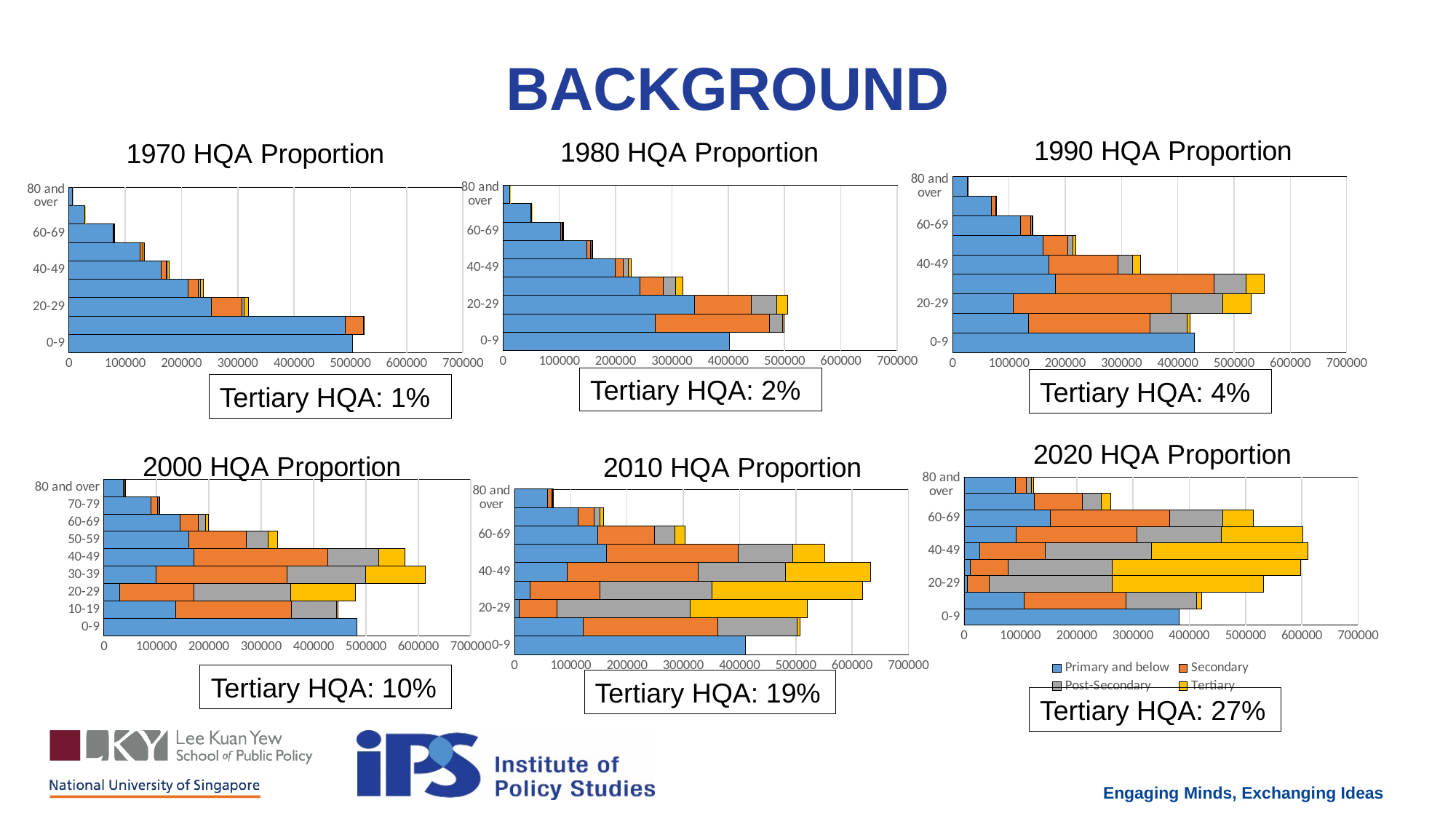
How many age-group categories are plotted in the 2000 HQA Proportion chart? 9 In the 1970 HQA Proportion chart, which age group has the shortest bar? 80 and over In the 2020 HQA Proportion chart, which bar is longer, 0-9 or 30-39? 30-39 How many charts are shown on the slide? 6 What kind of chart is the 1970 HQA Proportion chart? Stacked horizontal bar chart In the 1970 HQA Proportion chart, do the bar lengths rise or fall as the age group increases from 0-9 to 80 and over? fall How many series does the legend on the 2020 HQA Proportion chart list? 4 In the 1970 HQA Proportion chart, which age group has the longest bar? 10-19 In the 2000 HQA Proportion chart, is the total bar for the 30-39 age group greater or less than 500000? greater In the 1970 HQA Proportion chart, is the total bar for the 0-9 age group greater or less than 400000? greater Which series does the yellow colour represent in the legend of the 2020 HQA Proportion chart? Tertiary In the 1980 HQA Proportion chart, is the total bar for the 80 and over age group greater or less than 100000? less